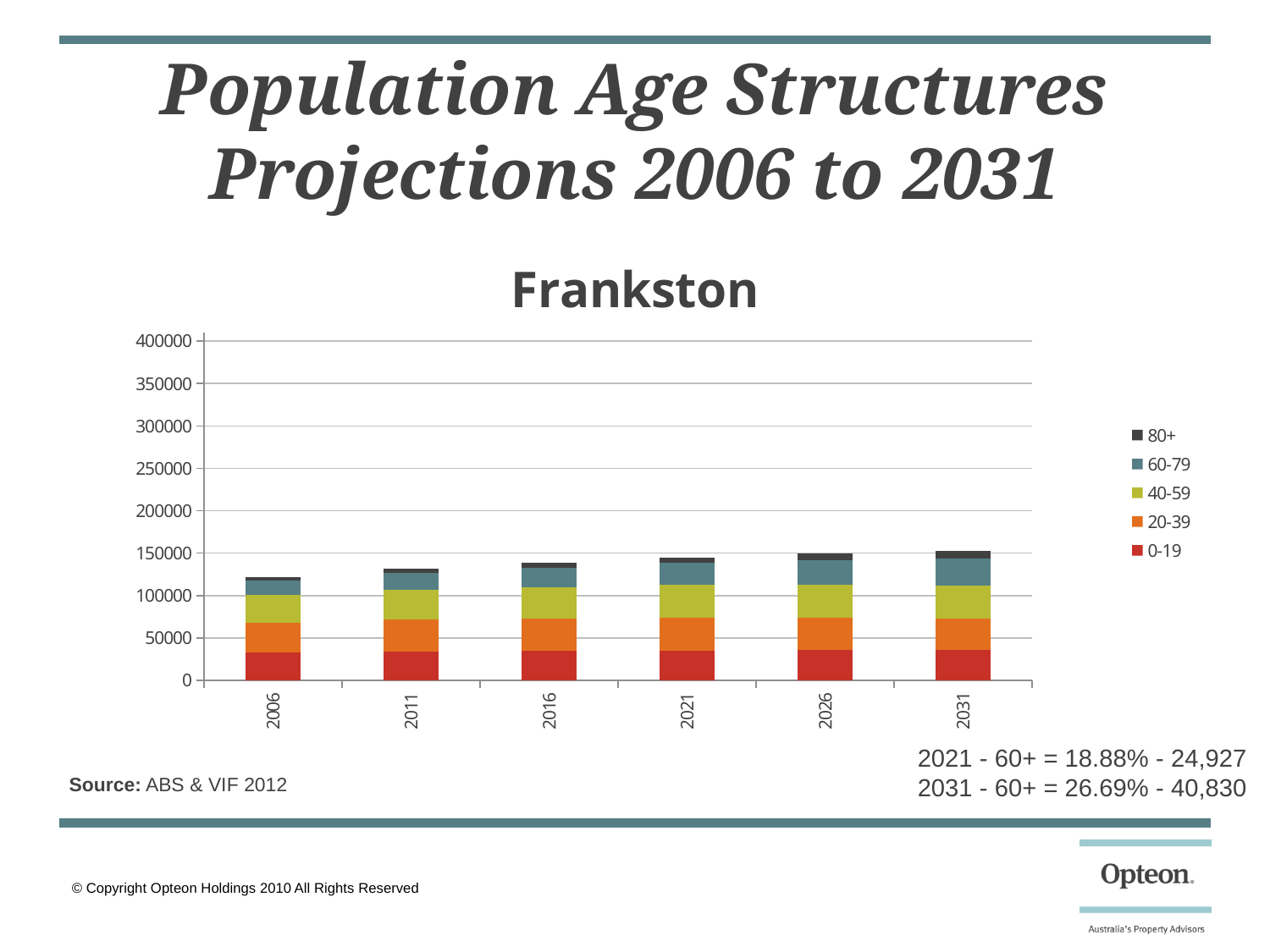
What kind of chart is shown on the slide? Stacked bar chart Is the total population for 2006 greater or less than 100000? greater Which age group is shown at the bottom of each stacked bar? 0-19 Which year has the highest total population in the chart? 2031 Is the total population for 2006 greater or less than 150000? less Does the total population rise or fall from 2006 to 2031? rise How many age-group series does the legend list? 5 Which year has a larger total population, 2006 or 2031? 2031 Is the total population for 2021 greater or less than 150000? less Which year has the lowest total population in the chart? 2006 How many years are shown along the x axis of the chart? 6 What is the title of the chart? Frankston